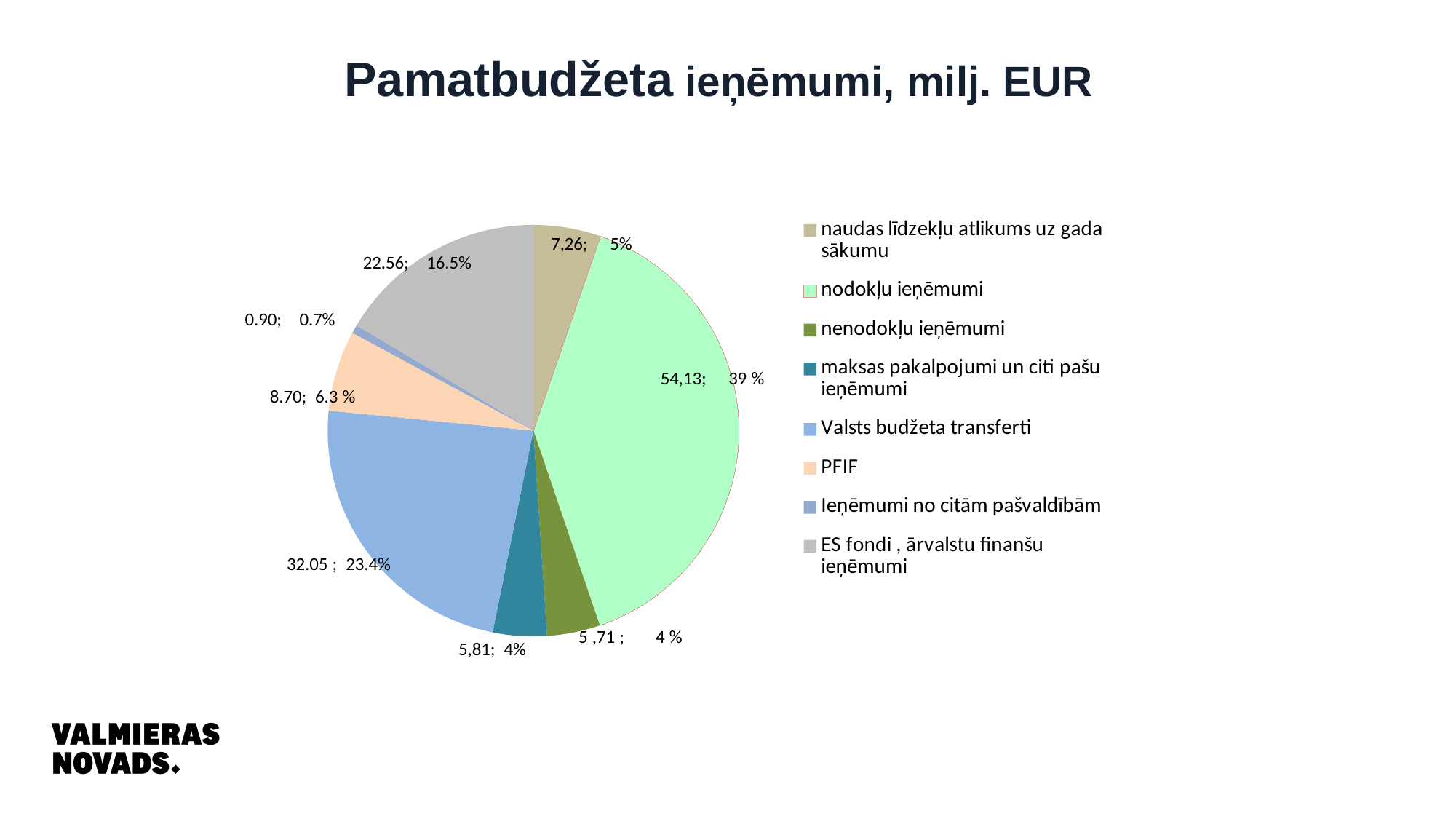
How many entries does the legend list? 8 What is the title of the chart? Pamatbudžeta ieņēmumi, milj. EUR What is the value shown for ES fondi, ārvalstu finanšu ieņēmumi? 22.56 What is the difference between the value for ES fondi, ārvalstu finanšu ieņēmumi and the value for PFIF? 13.86 What is the value shown for nodokļu ieņēmumi? 54,13 What kind of chart is shown on the slide? pie chart How many slices does the pie chart have? 8 Which category has the smallest slice of the pie? Ieņēmumi no citām pašvaldībām Which category has the largest slice of the pie? nodokļu ieņēmumi What share of the pie does PFIF represent? 6.3 % What share of the pie does Valsts budžeta transferti represent? 23.4% Which is larger, the value for nodokļu ieņēmumi or the value for Valsts budžeta transferti? nodokļu ieņēmumi